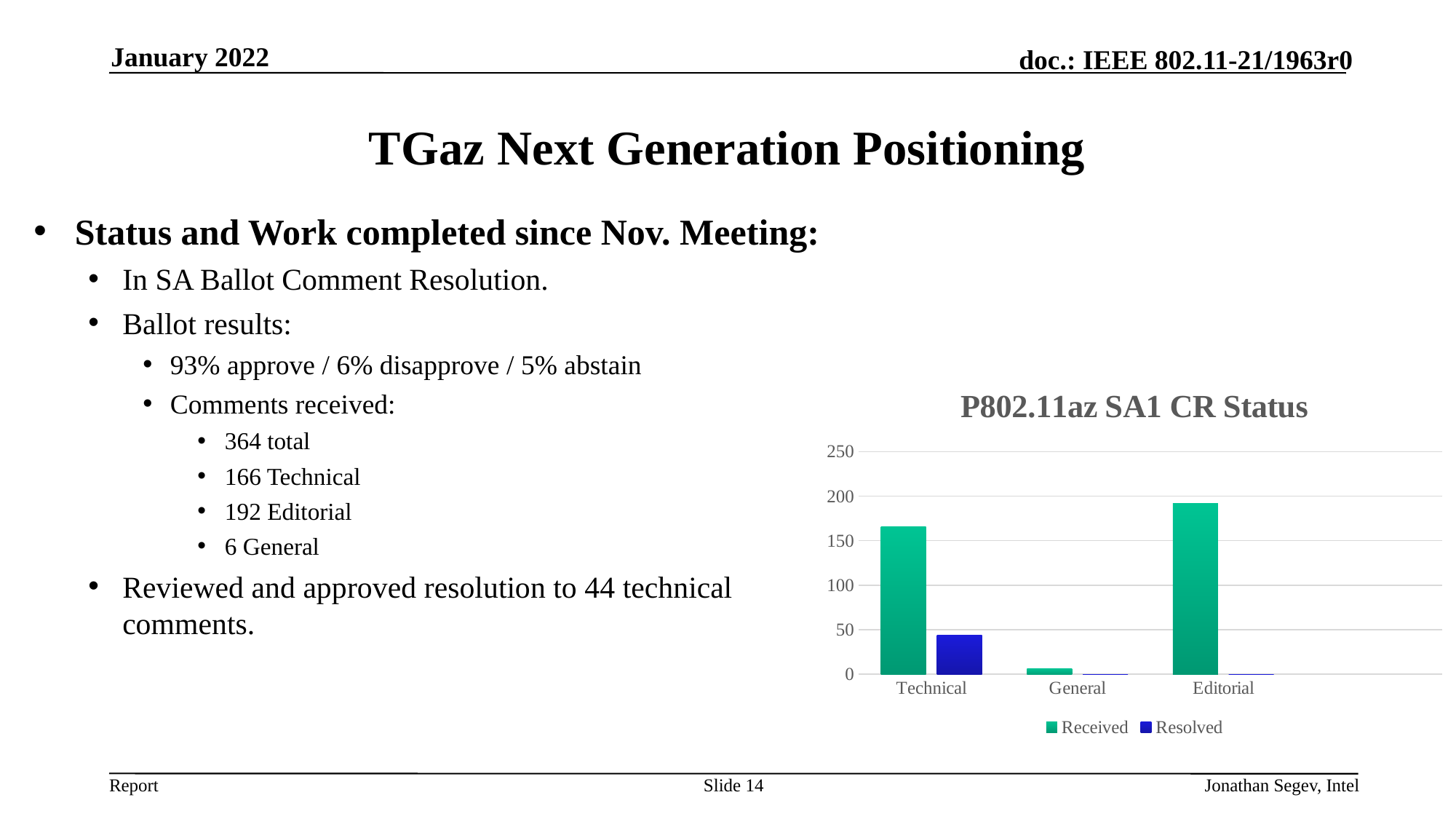
Is the Received value for Editorial greater or less than 150? greater Is the Received value for General greater or less than 50? less Which category has the highest Received value? Editorial Is the Resolved value for Technical greater or less than 50? less Which category has the lowest Received value? General Which series is shown in blue in the chart? Resolved How many categories are shown on the x axis of the chart? 3 How many series does the chart legend list? 2 What is the title of the chart? P802.11az SA1 CR Status What kind of chart is shown on the slide? bar chart Which category has the highest Resolved value? Technical Which is larger for Technical: the Received value or the Resolved value? Received